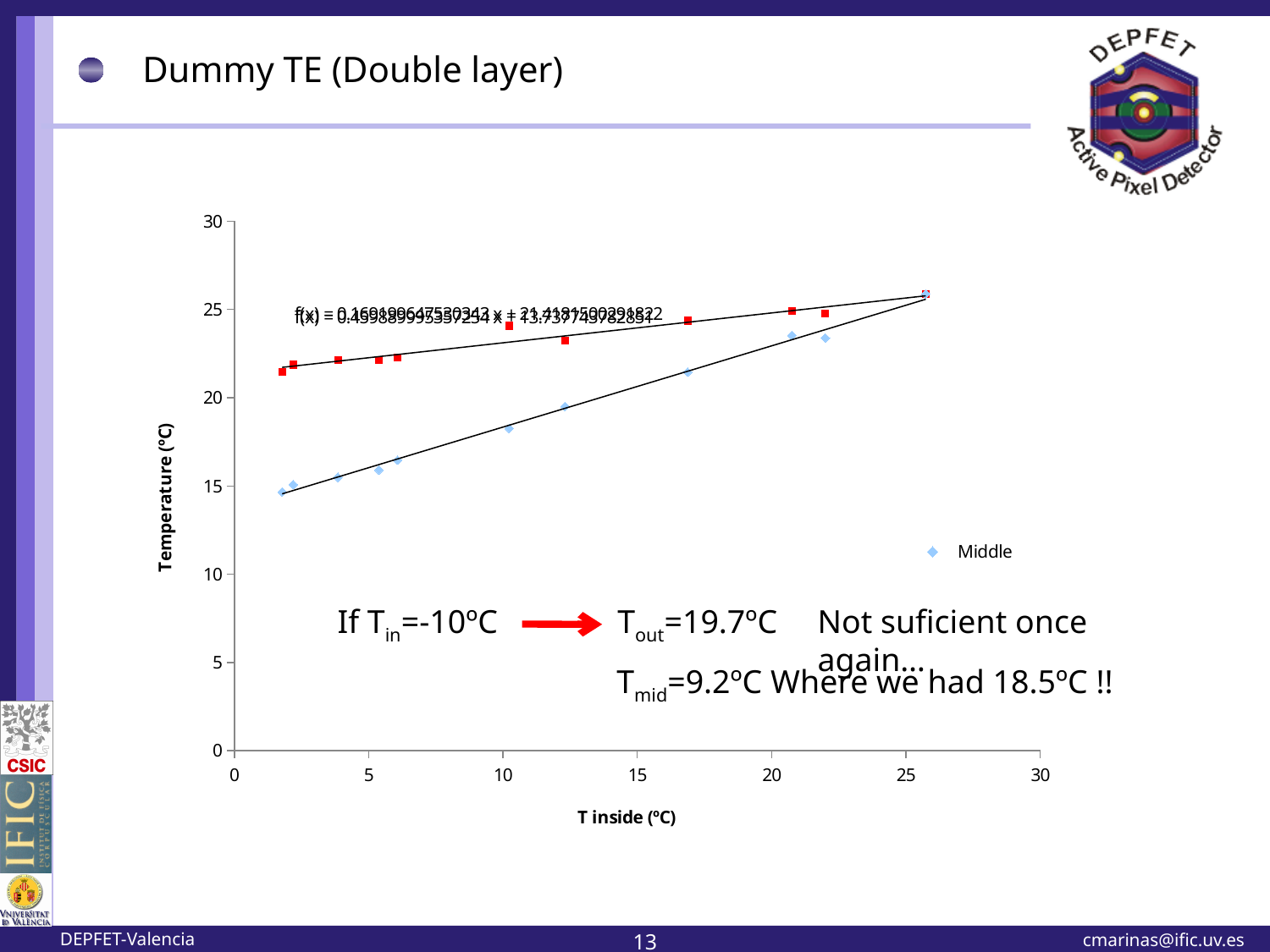
What kind of chart is shown on the slide? scatter chart Do the Middle (blue diamond) values rise or fall as T inside increases? rise At a T inside of about 10 ºC, is the Middle (blue diamond) value greater or less than 20? less At a T inside of about 10 ºC, is the Middle (blue diamond) value greater or less than 15? greater How many series does the chart's legend list? 1 At a T inside of about 2 ºC, is the red square value greater or less than 20? greater What series name appears in the chart's legend? Middle What is the maximum value shown on the y axis of the chart? 30 What is the title of the y axis of the chart? Temperature (ºC) At a T inside of about 10 ºC, which series has the higher temperature, the red squares or the Middle blue diamonds? red squares Do the red square values rise or fall as T inside increases? rise